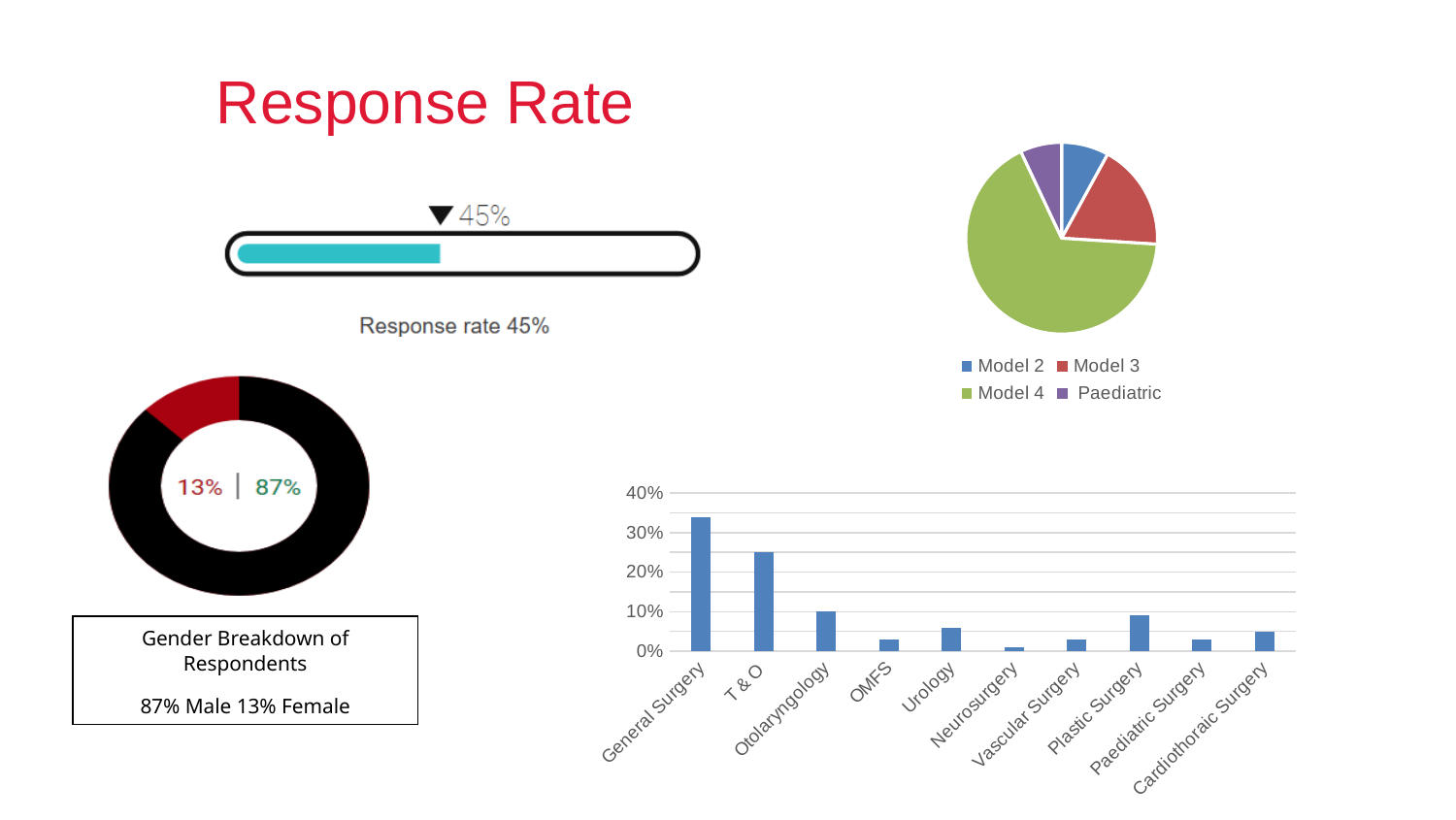
How many entries does the legend of the pie chart at the top right list? 4 What kind of chart is the chart at the bottom right of the slide? bar chart In the bar chart at the bottom right, is the value for General Surgery greater or less than 30%? greater In the bar chart at the bottom right, which is larger, General Surgery or T & O? General Surgery In the pie chart at the top right, which slice is larger, Model 3 or Model 2? Model 3 In the donut chart on the left showing the gender breakdown of respondents, what percentage is female? 13% In the pie chart at the top right, which category has the largest slice? Model 4 In the bar chart at the bottom right, is the value for T & O greater or less than 20%? greater In the bar chart at the bottom right, which specialty has the lowest value? Neurosurgery How many specialties are shown on the x axis of the bar chart at the bottom right? 10 In the bar chart at the bottom right, which specialty has the highest value? General Surgery